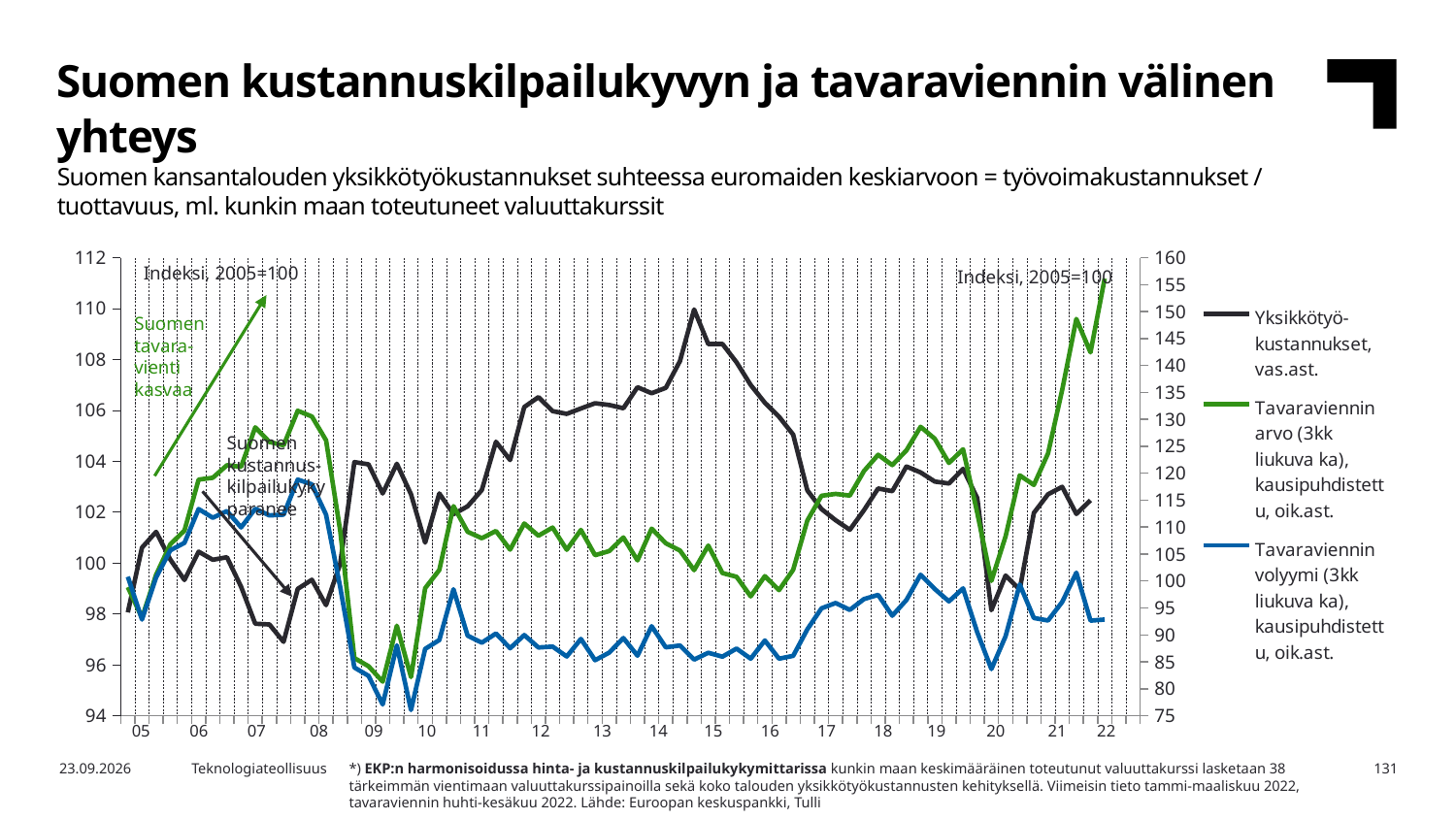
How many year labels are shown on the x axis? 18 What kind of chart is shown on the slide? line chart Is the peak value of the Yksikkötyökustannukset line around 2014–2015 greater or less than 108 on the left axis? greater Is the lowest value of the Tavaraviennin volyymi line around 2009 greater or less than 85 on the right axis? less At the end of 2022, which is higher on the right axis: Tavaraviennin arvo or Tavaraviennin volyymi? Tavaraviennin arvo Does the Yksikkötyökustannukset line rise or fall between its 2014–2015 peak and 2017? fall Does the Tavaraviennin arvo line rise or fall from 2020 to 2022? rise How many series does the legend list? 3 What index base is stated in the chart annotations? Indeksi, 2005=100 Which series is plotted on the left axis (vas.ast.) according to the legend? Yksikkötyökustannukset Is the value of the Tavaraviennin arvo line at the end of 2022 greater or less than 150 on the right axis? greater